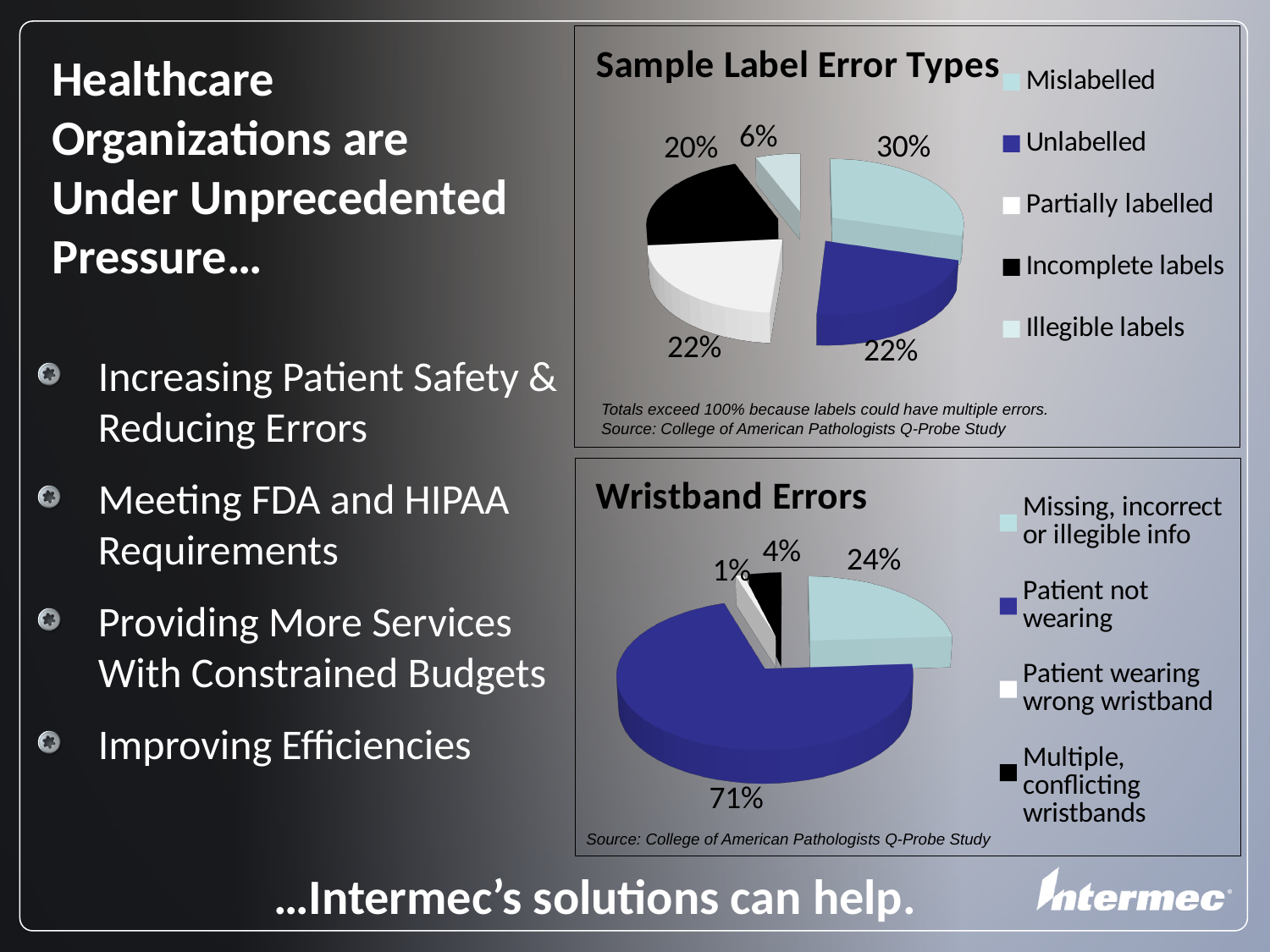
In the Wristband Errors chart, which is larger: Missing, incorrect or illegible info or Multiple, conflicting wristbands? Missing, incorrect or illegible info In the Sample Label Error Types chart, what percentage is shown for Mislabelled? 30% In the Sample Label Error Types chart, what percentage is shown for Incomplete labels? 20% In the Sample Label Error Types chart, which error type has the largest share? Mislabelled In the Wristband Errors chart, what percentage is shown for Multiple, conflicting wristbands? 4% In the Wristband Errors chart, what percentage is shown for Patient not wearing? 71% How many categories does the legend of the Sample Label Error Types chart list? 5 What source is cited below the Wristband Errors chart? College of American Pathologists Q-Probe Study In the Sample Label Error Types chart, what is the difference between the Mislabelled share and the Illegible labels share? 24% In the Wristband Errors chart, which category has the smallest share? Patient wearing wrong wristband In the Sample Label Error Types chart, which error type has the smallest share? Illegible labels What kind of chart is the Wristband Errors chart? Pie chart